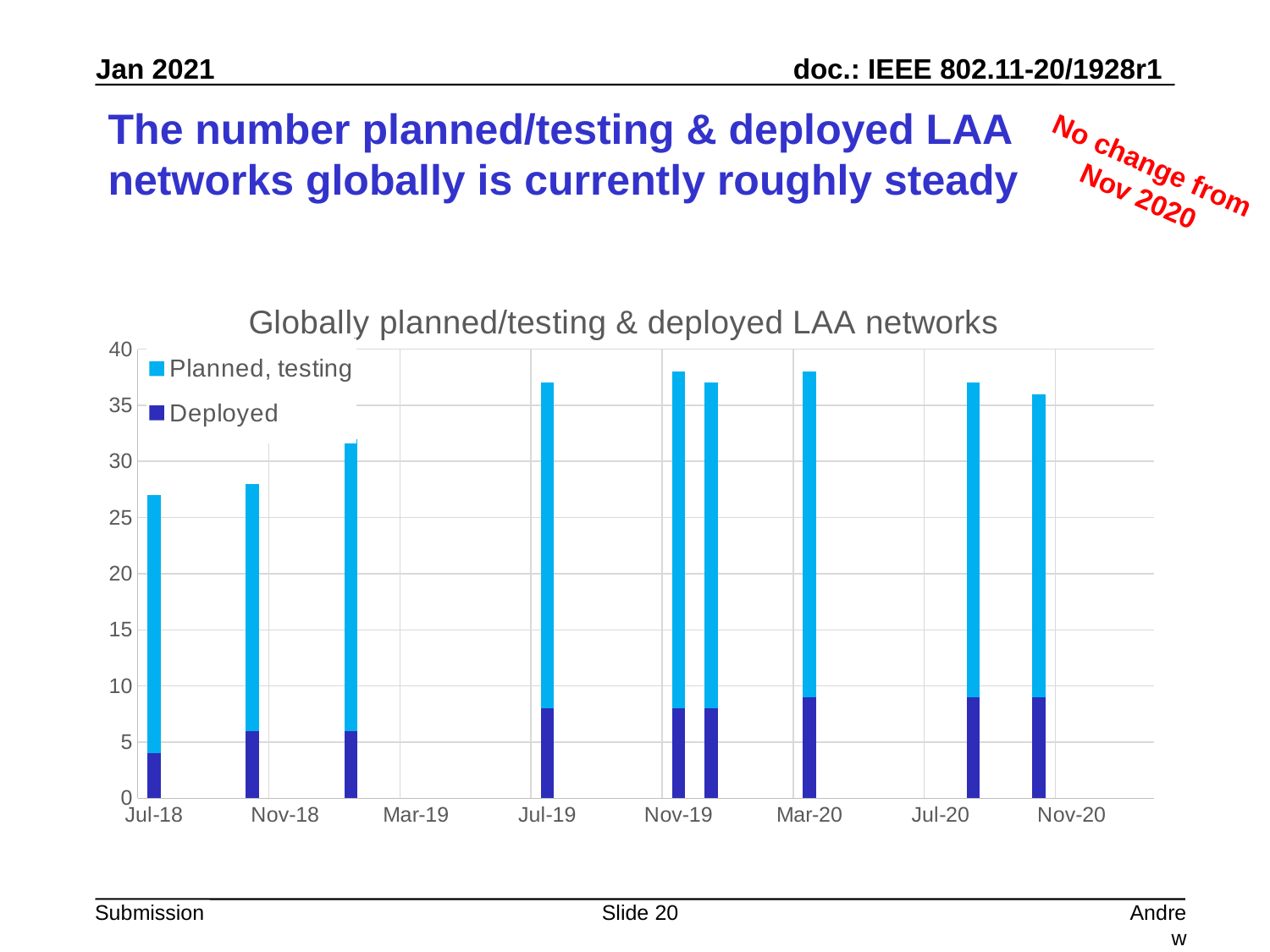
How many bars are plotted in the chart? 9 Is the Deployed value for Jul-18 greater or less than 5? less What kind of chart is shown on the slide? Bar chart Do the total bar heights generally rise or fall from Jul-18 to Nov-20? rise What is the title of the chart? Globally planned/testing & deployed LAA networks Which series is shown in dark blue in the chart? Deployed How many series does the chart's legend list? 2 Which bar has the larger total, Jul-18 or Mar-20? Mar-20 Is the total height of the bar at Mar-20 greater or less than 35? greater Which date has the lowest total number of networks? Jul-18 Is the total height of the bar at Jul-18 greater or less than 30? less